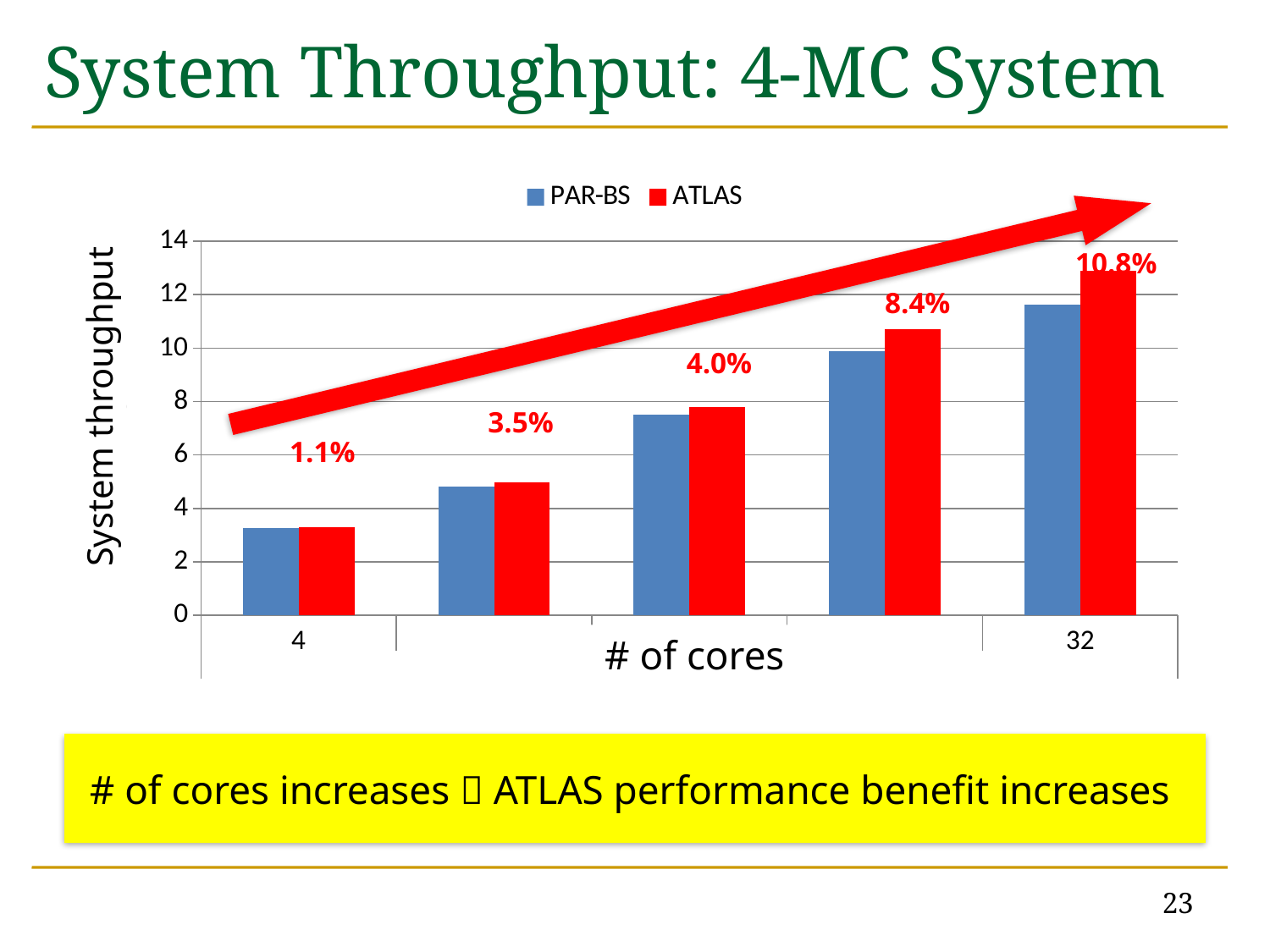
Is the PAR-BS system throughput for 4 cores greater or less than 4? less Is the ATLAS system throughput for 32 cores greater or less than 12? greater For 32 cores, which series has the higher system throughput, PAR-BS or ATLAS? ATLAS Do the system throughput values rise or fall as the number of cores increases along the x axis? rise What kind of chart is shown on the slide? bar chart What is the percentage improvement label shown above the bars for 32 cores? 10.8% What is the percentage improvement label shown above the bars for 4 cores? 1.1% Is the PAR-BS system throughput for 32 cores greater or less than 10? greater How many series does the legend list? 2 What are the two series named in the legend? PAR-BS and ATLAS Which core count has the highest ATLAS system throughput? 32 How many groups of bars (core counts) are plotted on the chart? 5